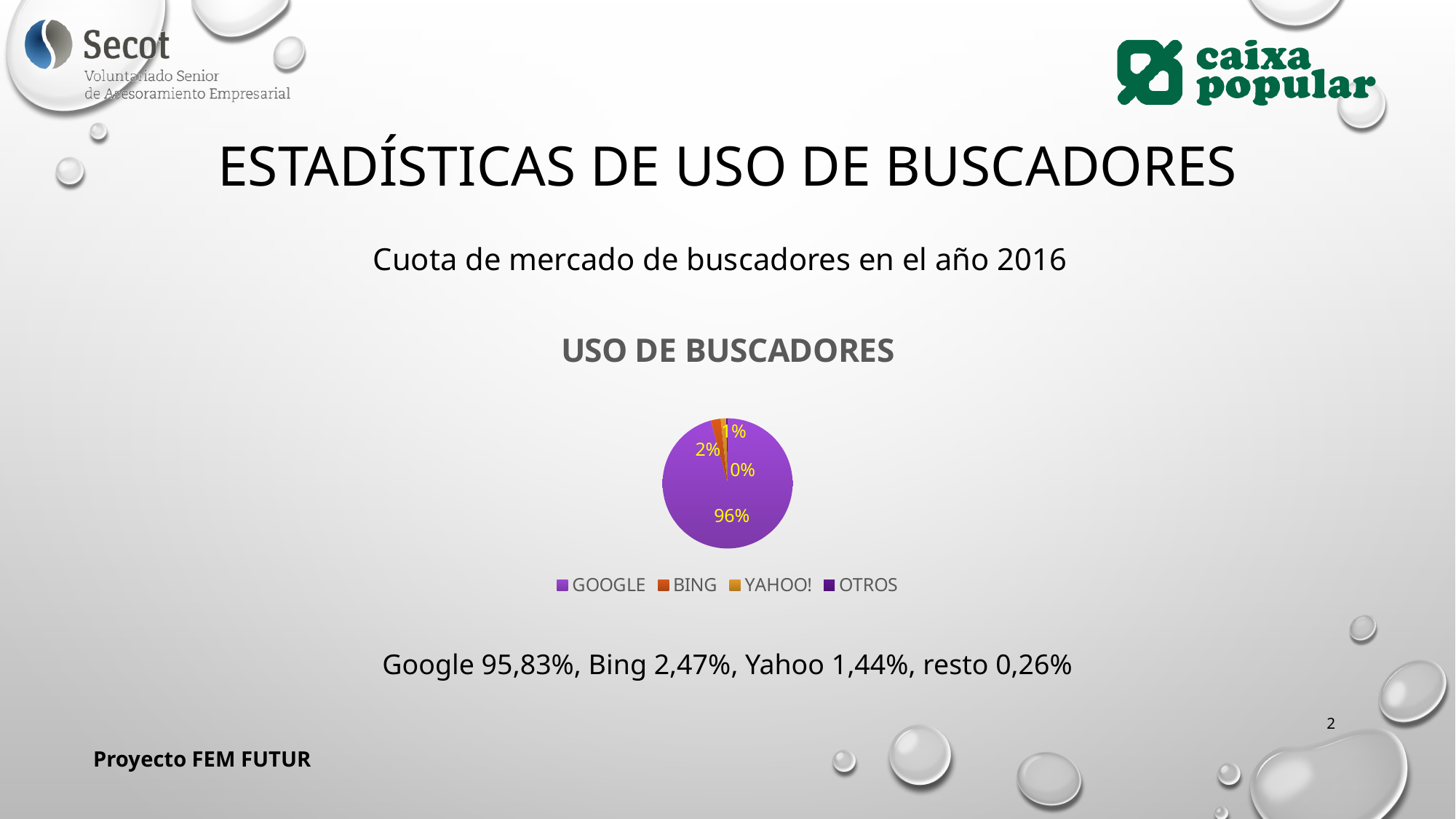
What is the value shown for OTROS? 0% Which category has the largest slice of the pie? GOOGLE How many slices does the pie chart have? 4 What is the title of the chart? USO DE BUSCADORES What share of the pie does GOOGLE have? 96% What is the difference between the GOOGLE share and the BING share? 94% How many entries does the chart legend list? 4 What is the value shown for YAHOO!? 1% What kind of chart is shown on the slide? pie chart Which category has the smallest slice of the pie? OTROS What is the value shown for BING? 2% Which is larger, the slice for BING or the slice for YAHOO!? BING